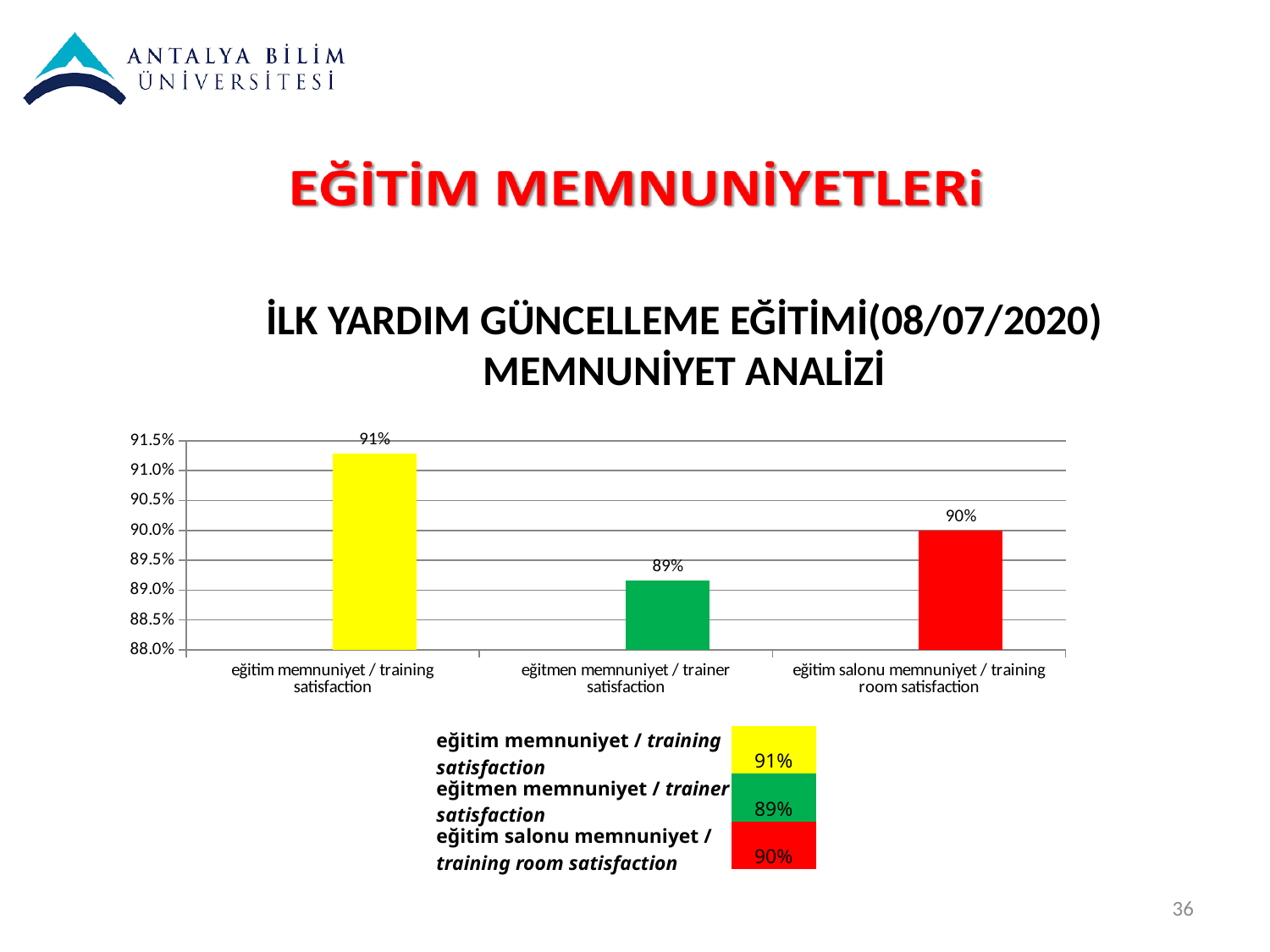
What is the difference between the training satisfaction value and the trainer satisfaction value? 2% Which category has the highest value? eğitim memnuniyet / training satisfaction What kind of chart is shown on the slide? bar chart What is the value for trainer satisfaction (eğitmen memnuniyet)? 89% Is the value for trainer satisfaction greater or less than 89.5%? less What is the title of the chart? İLK YARDIM GÜNCELLEME EĞİTİMİ(08/07/2020) MEMNUNİYET ANALİZİ What colour is the bar for training room satisfaction? red How many categories are shown on the chart? 3 What is the value for training satisfaction (eğitim memnuniyet)? 91% Which is larger: the value for training room satisfaction or the value for trainer satisfaction? training room satisfaction Which category has the lowest value? eğitmen memnuniyet / trainer satisfaction What is the value for training room satisfaction (eğitim salonu memnuniyet)? 90%